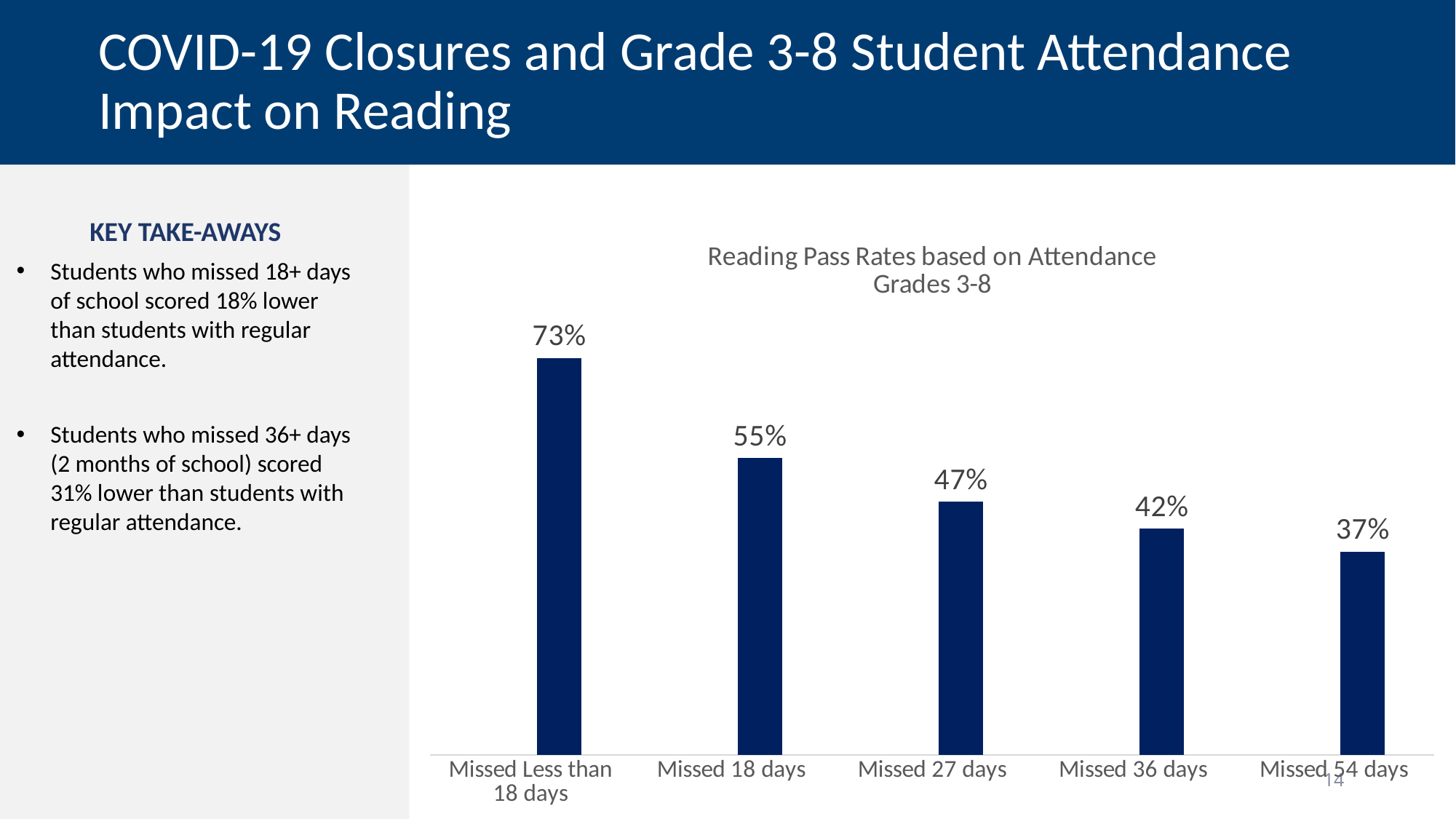
Which attendance category has the highest reading pass rate? Missed Less than 18 days What is the reading pass rate for students who missed 27 days? 47% What is the reading pass rate for students who missed less than 18 days? 73% How many attendance categories are shown in the chart? 5 What is the difference in reading pass rate between students who missed 18 days and those who missed 27 days? 8% What type of chart is shown on the slide? Bar chart What is the title of the chart? Reading Pass Rates based on Attendance Grades 3-8 Which attendance category has the lowest reading pass rate? Missed 54 days What is the reading pass rate for students who missed 54 days? 37% Which has a higher reading pass rate: students who missed 18 days or students who missed 36 days? Missed 18 days Do the reading pass rates rise or fall as the number of missed days increases along the x axis? Fall What is the difference in reading pass rate between students who missed less than 18 days and those who missed 36 days? 31%